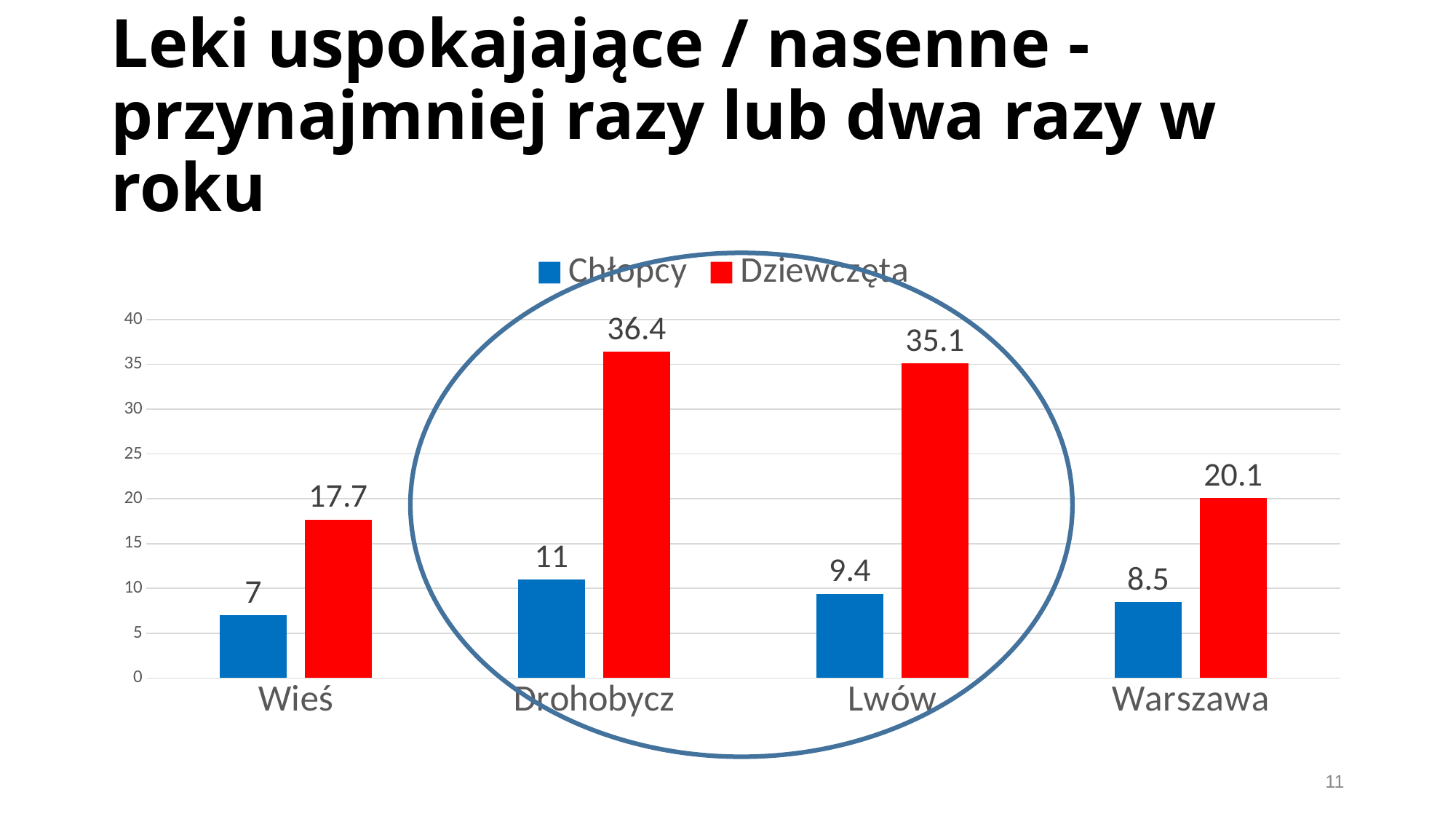
Which is larger: the Chłopcy value in Drohobycz or the Chłopcy value in Warszawa? Drohobycz What is the difference between the Dziewczęta and Chłopcy values in Lwów? 25.7 What is the value for Dziewczęta in Drohobycz? 36.4 What is the value for Chłopcy in Lwów? 9.4 What kind of chart is shown on the slide? bar chart Which category has the highest value for Dziewczęta? Drohobycz What is the value for Chłopcy in Wieś? 7 Which colour represents the Dziewczęta series? red What is the value for Dziewczęta in Warszawa? 20.1 How many categories are shown on the x axis? 4 How many series does the legend list? 2 Which category has the lowest value for Chłopcy? Wieś